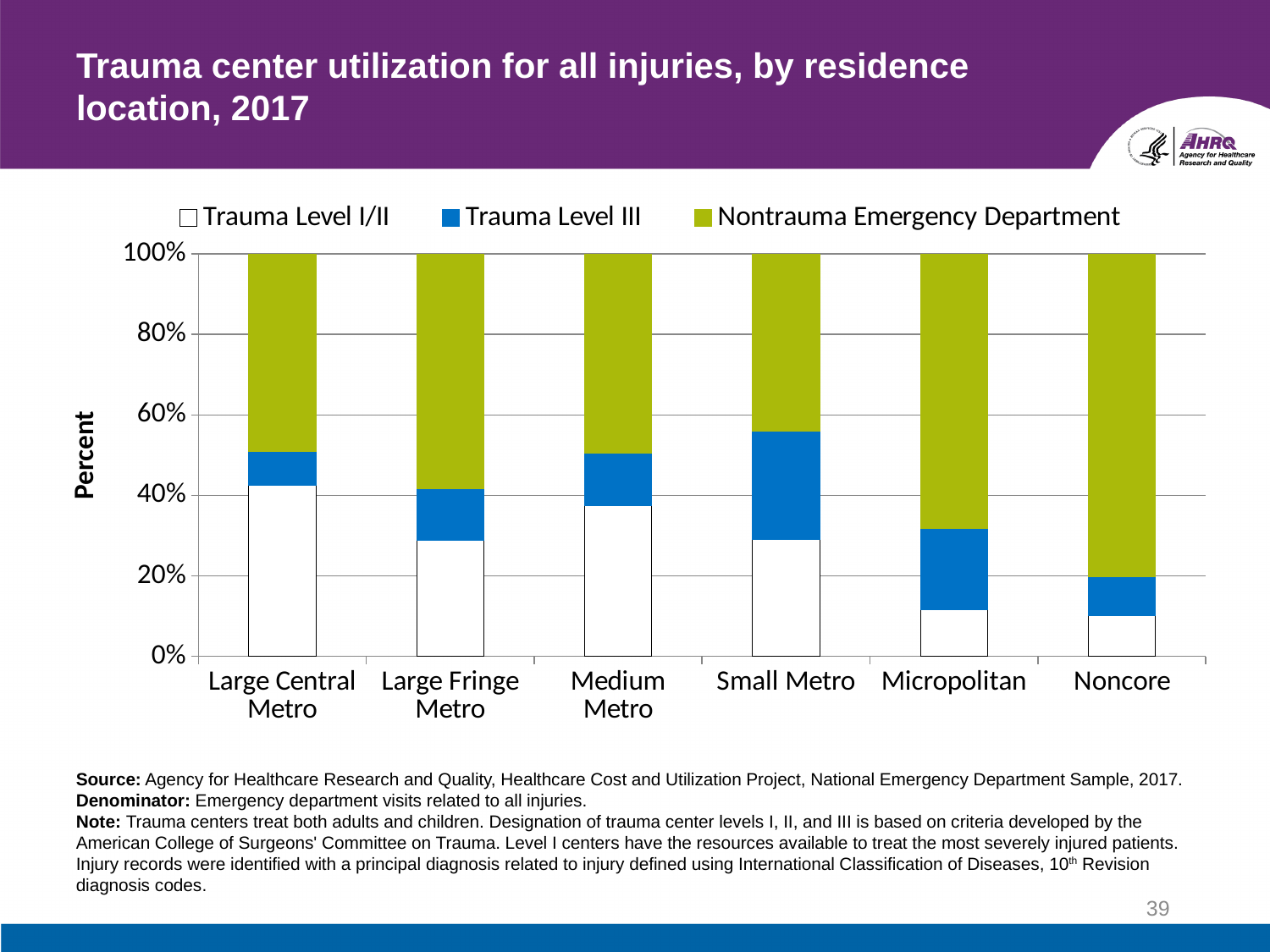
What kind of chart is shown on the slide? Stacked bar chart Which is larger, the Nontrauma Emergency Department share for Noncore or for Micropolitan? Noncore Is the Trauma Level I/II share for Large Central Metro greater or less than 40%? greater Which residence location has the largest Trauma Level I/II share? Large Central Metro Which residence location has the largest Trauma Level III share? Small Metro Which residence location has the smallest Trauma Level I/II share? Noncore Which is larger, the Trauma Level I/II share for Large Central Metro or for Large Fringe Metro? Large Central Metro What is the title of the chart? Trauma center utilization for all injuries, by residence location, 2017 Is the Trauma Level I/II share for Micropolitan greater or less than 20%? less Which residence location has the largest Nontrauma Emergency Department share? Noncore How many residence location categories are shown on the x axis? 6 How many series does the legend list? 3